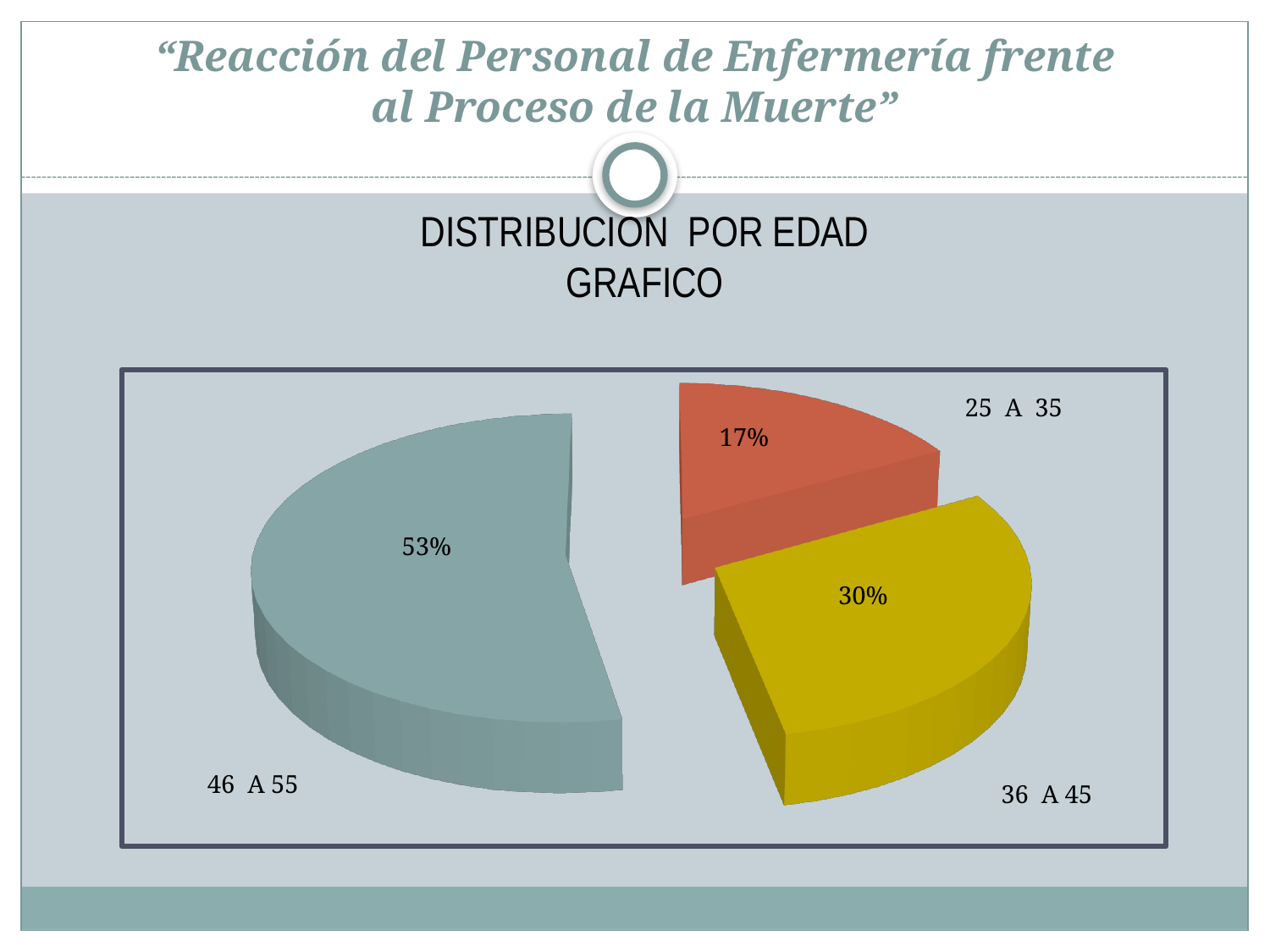
What is the title of the chart? DISTRIBUCION POR EDAD GRAFICO What percentage is shown for the 25 A 35 age group? 17% What type of chart is shown on the slide? Pie chart What is the difference in percentage points between the 36 A 45 and 25 A 35 groups? 13 How many age groups are shown in the pie chart? 3 What percentage is shown for the 36 A 45 age group? 30% Which is larger, the share for 36 A 45 or the share for 25 A 35? 36 A 45 What colour is the slice for the 25 A 35 age group? Red Which age group has the smallest share of the pie? 25 A 35 Which age group has the largest share of the pie? 46 A 55 What percentage is shown for the 46 A 55 age group? 53% What is the difference in percentage points between the 46 A 55 and 36 A 45 groups? 23